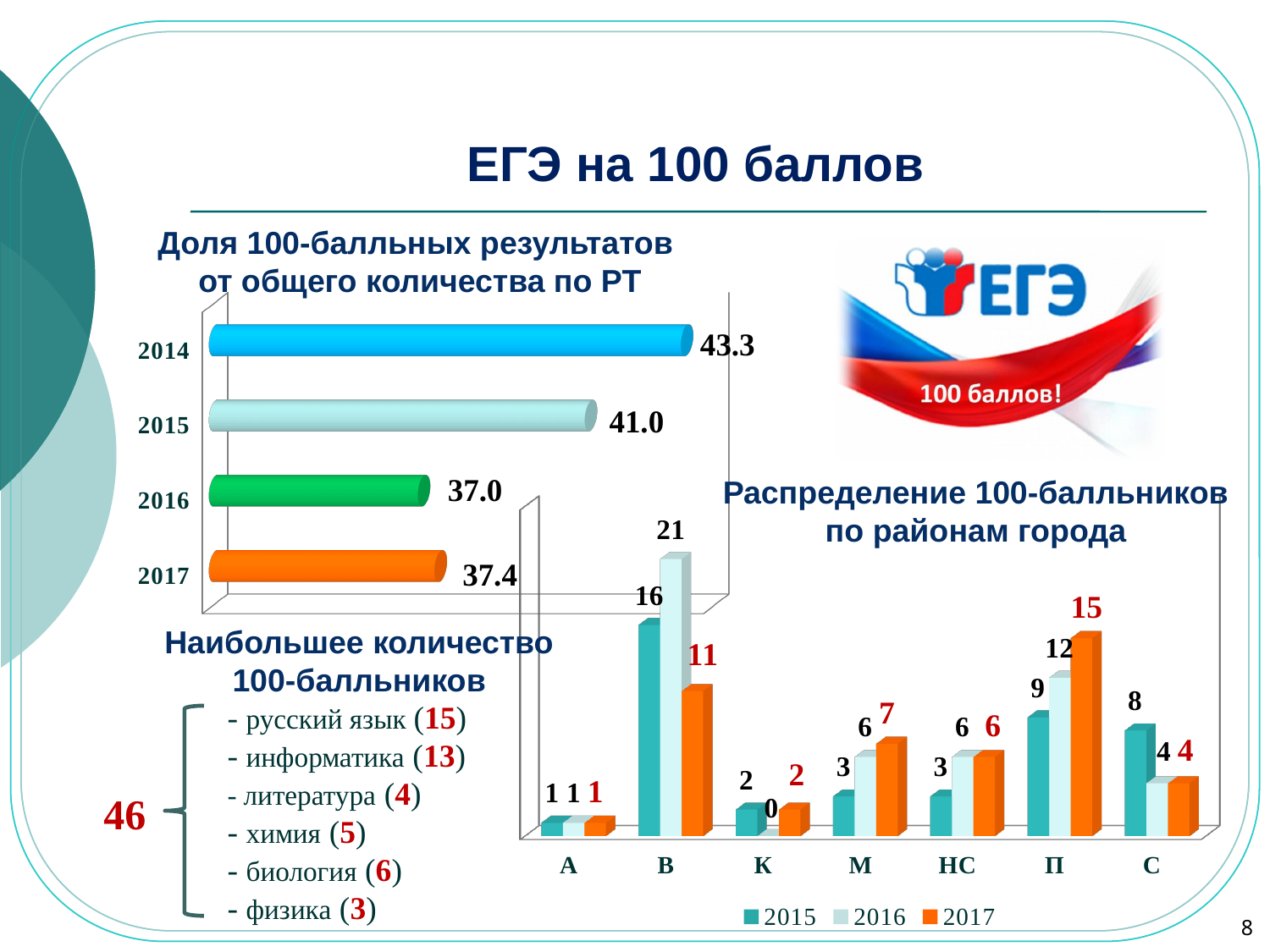
In the chart 'Распределение 100-балльников по районам города', how many districts are shown on the x axis? 7 In the chart 'Доля 100-балльных результатов от общего количества по РТ', which year has the lowest value? 2016 In the chart 'Распределение 100-балльников по районам города', which district has the highest value in 2017? П How many series does the legend of the chart 'Распределение 100-балльников по районам города' list? 3 In the chart 'Доля 100-балльных результатов от общего количества по РТ', what is the value for 2014? 43.3 In the chart 'Доля 100-балльных результатов от общего количества по РТ', how many years are shown? 4 In the chart 'Распределение 100-балльников по районам города', what is the difference between the 2016 and 2017 values for district В? 10 In the chart 'Доля 100-балльных результатов от общего количества по РТ', what is the difference between the 2014 and 2015 values? 2.3 In the chart 'Распределение 100-балльников по районам города', what is the value for district П in 2017? 15 In the chart 'Распределение 100-балльников по районам города', which is larger for district С: the 2015 value or the 2016 value? 2015 What kind of chart is 'Доля 100-балльных результатов от общего количества по РТ'? bar chart In the chart 'Распределение 100-балльников по районам города', what is the value for district В in 2016? 21